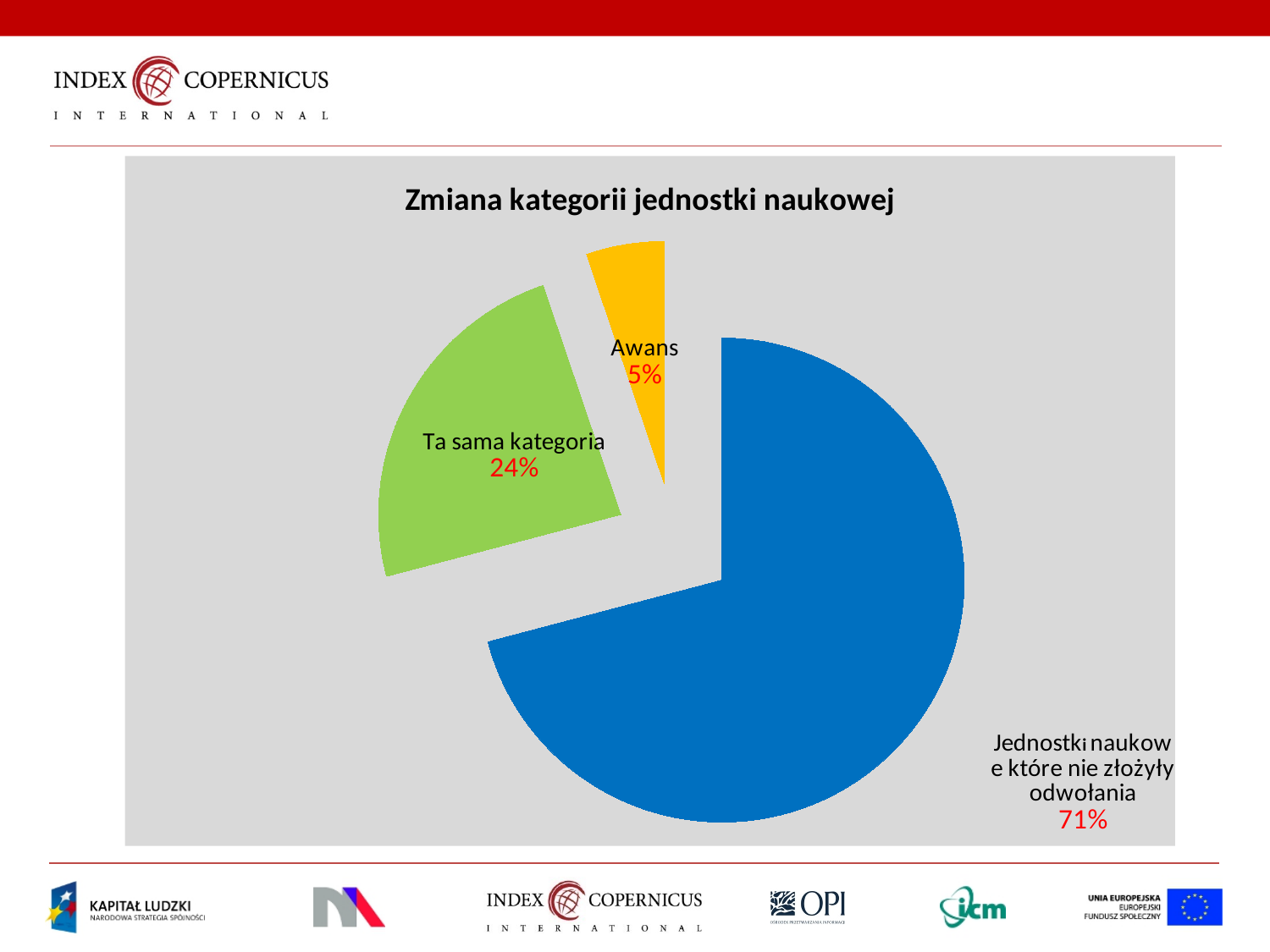
What colour is the slice labelled 'Awans'? yellow How many slices does the pie chart have? 3 Which slice of the pie is the largest? Jednostki naukowe które nie złożyły odwołania What share of the pie is labelled 'Jednostki naukowe które nie złożyły odwołania'? 71% What is the difference in percentage points between 'Jednostki naukowe które nie złożyły odwołania' and 'Ta sama kategoria'? 47 What kind of chart is shown on the slide? pie chart Which is larger, the share for 'Ta sama kategoria' or the share for 'Awans'? Ta sama kategoria What is the difference in percentage points between 'Ta sama kategoria' and 'Awans'? 19 What share of the pie is labelled 'Awans'? 5% Which slice of the pie is the smallest? Awans What is the title of the chart? Zmiana kategorii jednostki naukowej What share of the pie is labelled 'Ta sama kategoria'? 24%